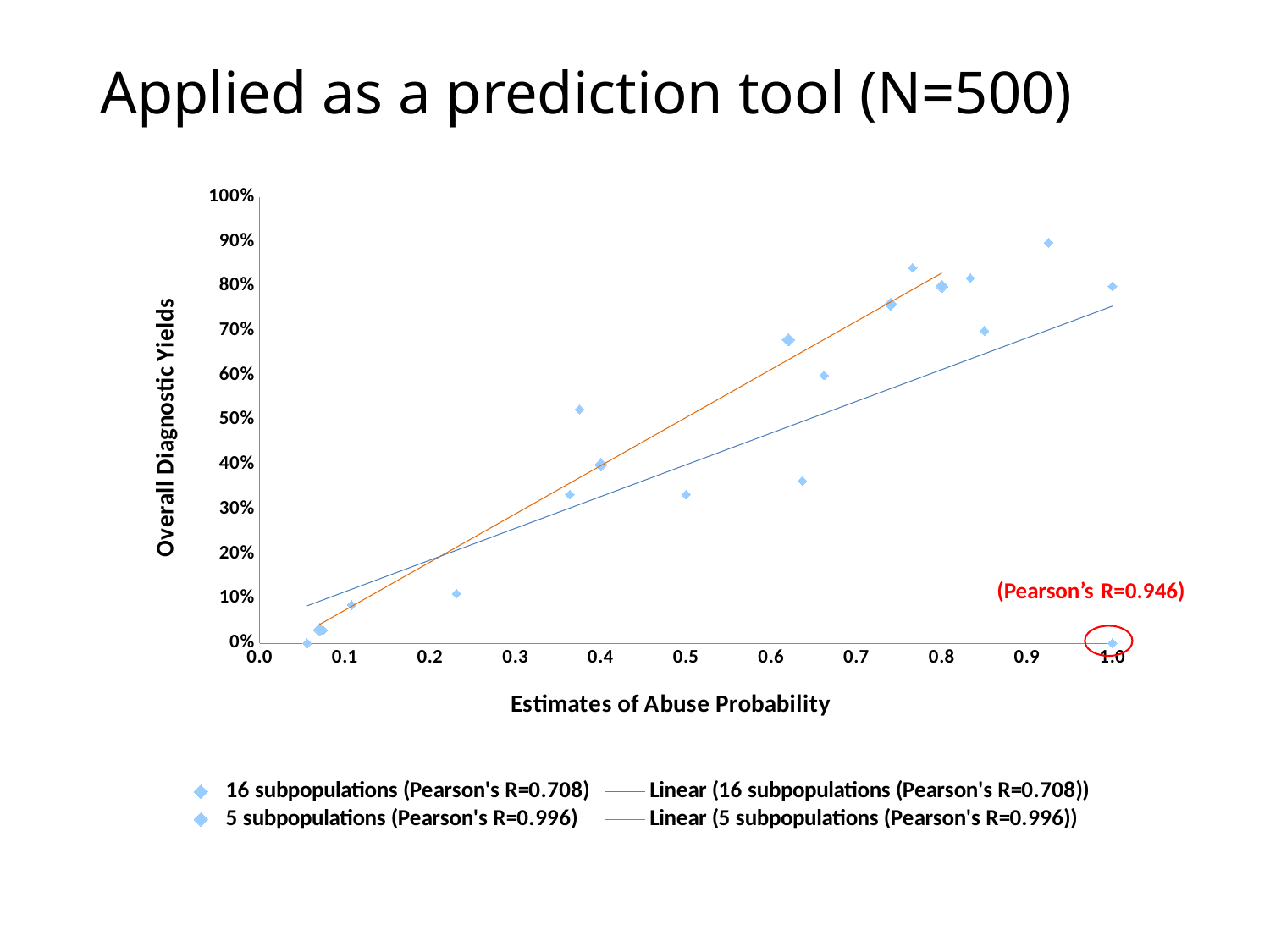
How many entries does the chart legend list? 4 What Pearson's R value is given in the legend for the 16 subpopulations series? 0.708 What is the title of the slide containing the chart? Applied as a prediction tool (N=500) Is the Overall Diagnostic Yield of the highest point, near an abuse probability estimate of 0.92, greater or less than 80%? greater Is the Overall Diagnostic Yield of the point at an abuse probability estimate of about 0.5 greater or less than 40%? less Do the Overall Diagnostic Yields generally rise or fall as the Estimates of Abuse Probability increase along the x axis? rise What kind of chart is shown on the slide? scatter chart What is the Overall Diagnostic Yield of the circled point at an abuse probability estimate of 1.0? 0% What is the label of the chart's y axis? Overall Diagnostic Yields What is the label of the chart's x axis? Estimates of Abuse Probability What Pearson's R value is printed in red on the chart? 0.946 What Pearson's R value is given in the legend for the 5 subpopulations series? 0.996